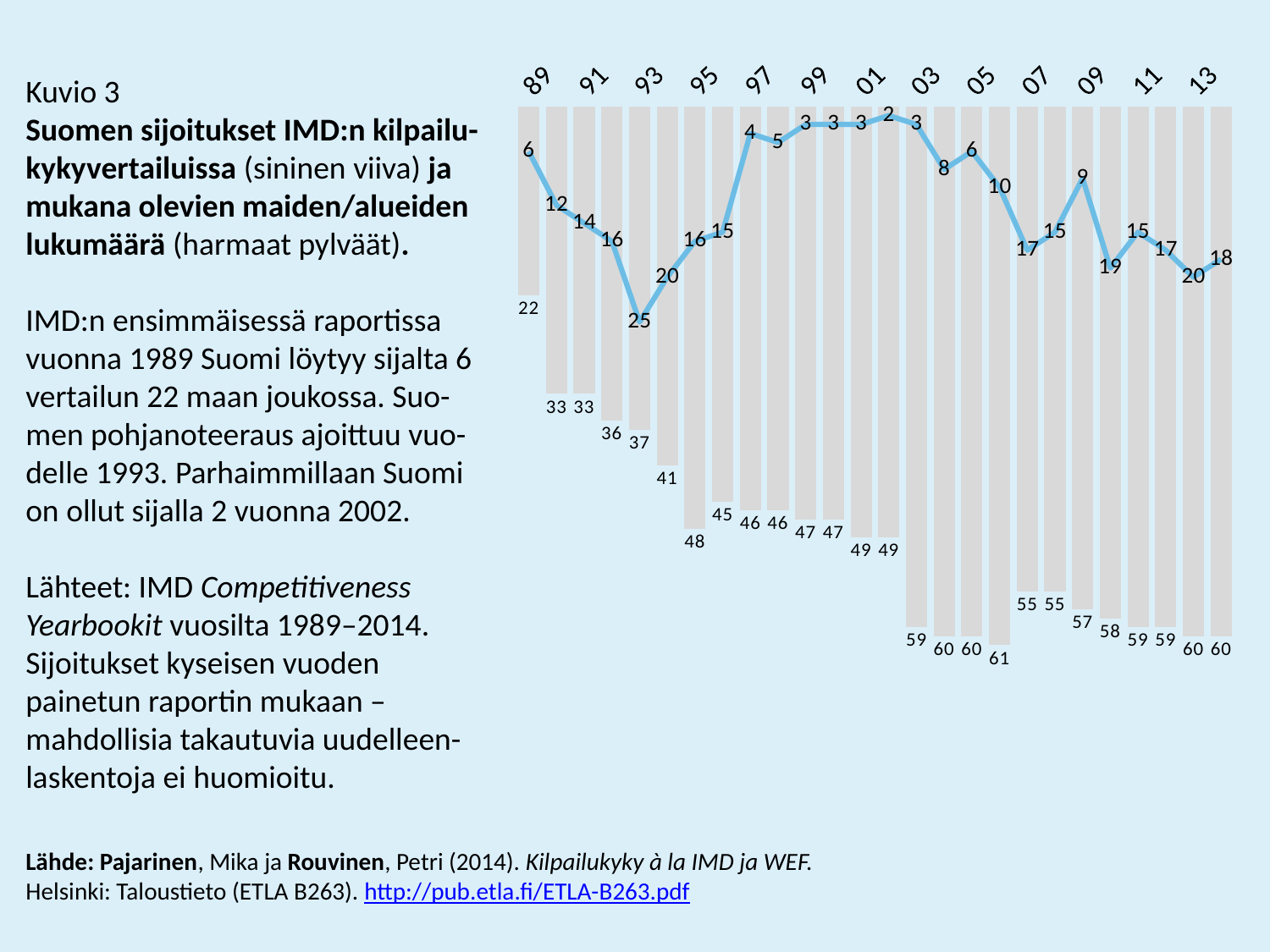
What is the value of the blue line at the x-axis label 09? 9 What is the value of the grey bar at the x-axis label 07? 55 How many countries/regions (grey bar) are shown at the x-axis label 89? 22 Which has the larger blue-line value, the label 93 or the label 95? 93 How many labels are shown on the x axis? 13 What is the value of the grey bar at the x-axis label 13? 60 What is the value of the blue line at the x-axis label 93? 25 What kind of chart is this? Combined bar and line chart What is Finland's ranking (blue line) at the x-axis label 89? 6 What is the largest value shown on any grey bar? 61 What is the smallest value shown on the blue line? 2 What is the difference between the grey bar values at labels 13 and 89? 38